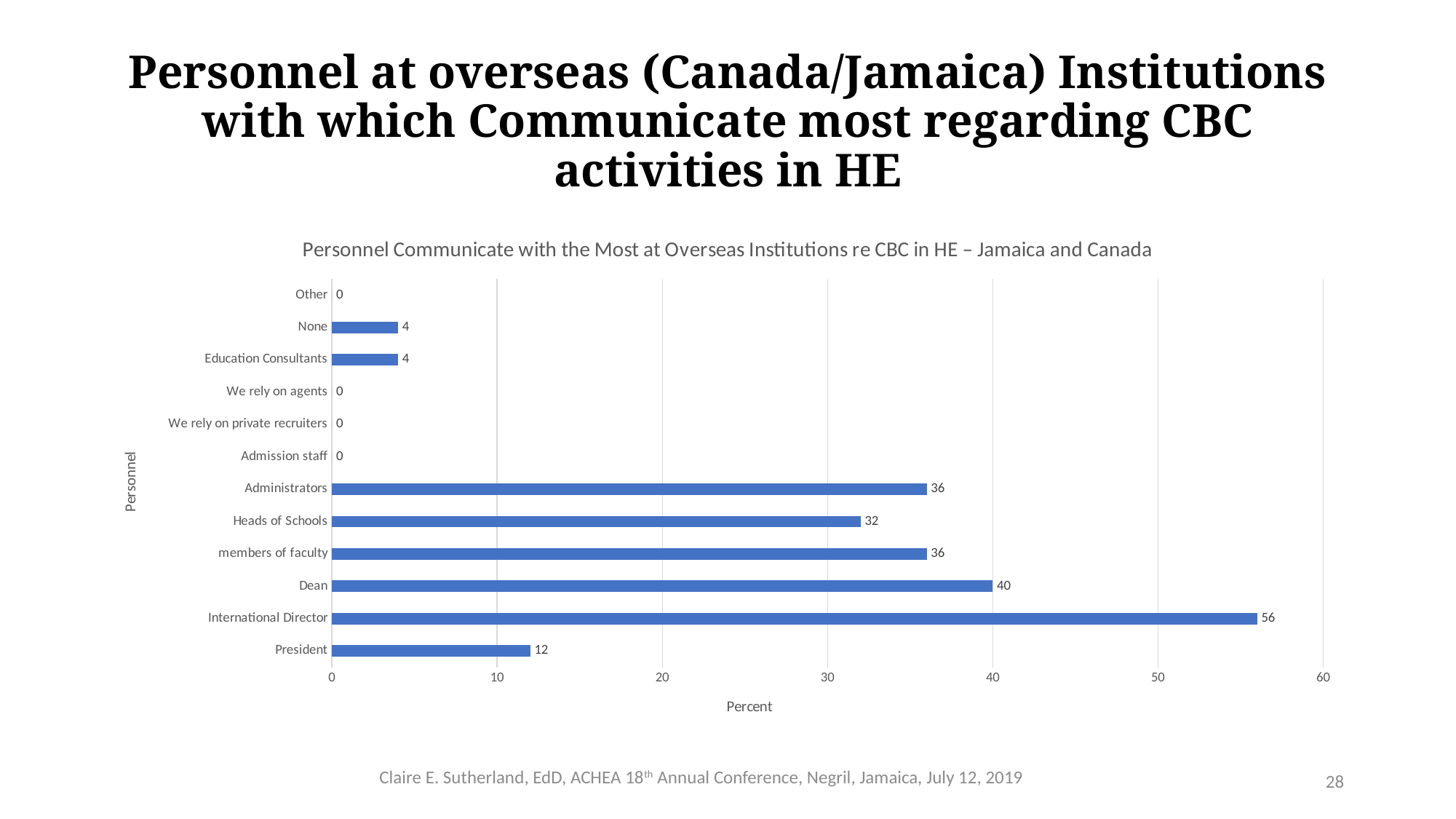
What is the value for President? 12 Which category has the highest value? International Director How many categories are shown on the y axis? 12 What is the difference between the values for International Director and Dean? 16 Which is larger, the value for Heads of Schools or the value for members of faculty? members of faculty What kind of chart is shown? bar chart What is the difference between the values for Administrators and President? 24 What is the value for Dean? 40 What is the label of the x axis? Percent What is the value for Heads of Schools? 32 What is the value for International Director? 56 How many categories have a value of 0? 4